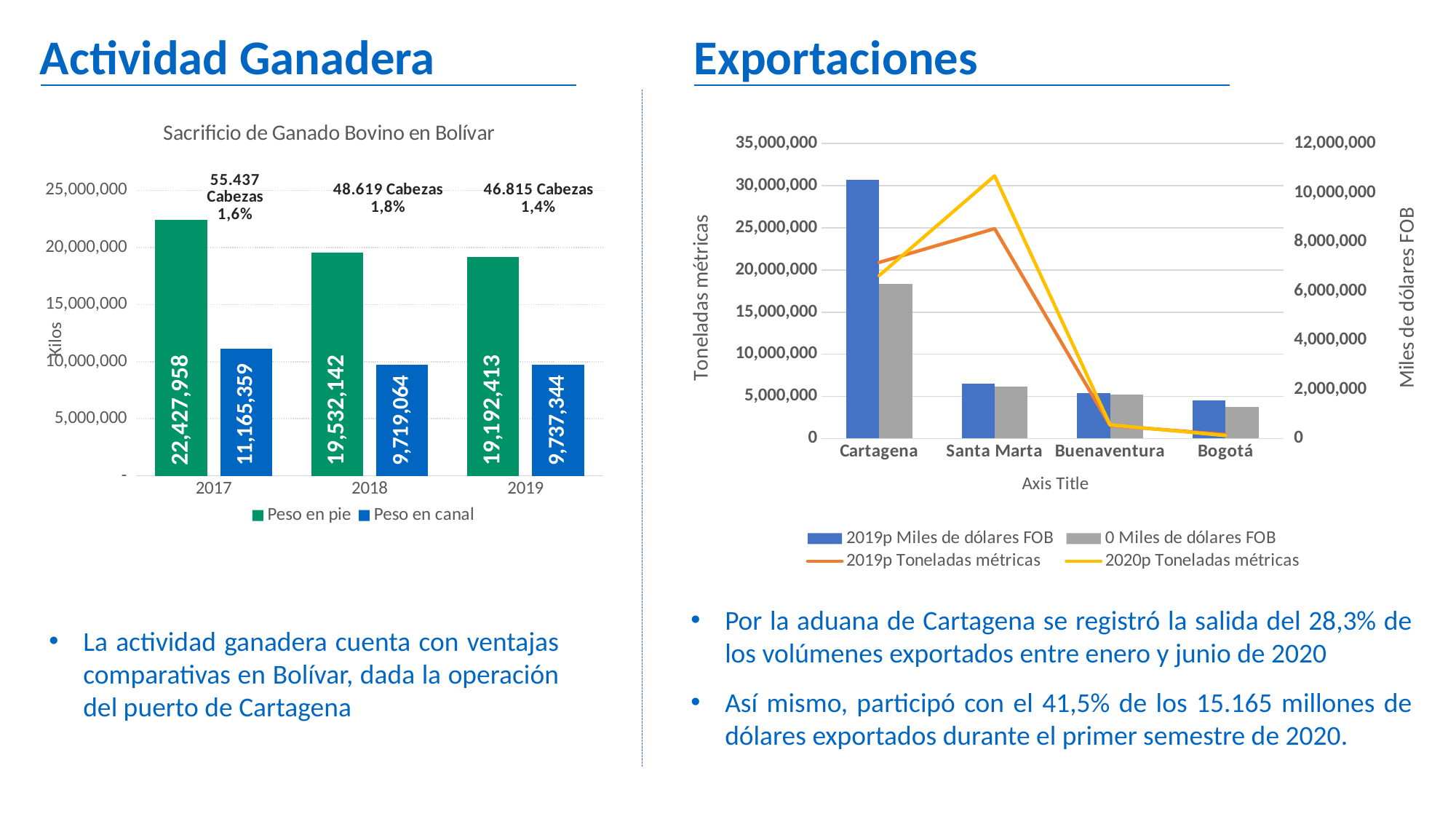
What kind of chart is the Exportaciones chart on the right? Combined bar and line chart In the 'Sacrificio de Ganado Bovino en Bolívar' chart, how many years are shown on the x axis? 3 How many series does the legend of the Exportaciones chart list? 4 In the 'Sacrificio de Ganado Bovino en Bolívar' chart, what is the value of Peso en canal for 2019? 9,737,344 In the 'Sacrificio de Ganado Bovino en Bolívar' chart, which year has the highest Peso en canal? 2017 In the Exportaciones chart, is the 2019p Miles de dólares FOB value for Cartagena greater or less than 30,000,000? less In the 'Sacrificio de Ganado Bovino en Bolívar' chart, what is the value of Peso en pie for 2017? 22,427,958 In the Exportaciones chart, which is larger for 2019p Miles de dólares FOB: Santa Marta or Bogotá? Santa Marta In the 'Sacrificio de Ganado Bovino en Bolívar' chart, what is the difference between Peso en pie and Peso en canal in 2017? 11,262,599 In the 'Sacrificio de Ganado Bovino en Bolívar' chart, what number of Cabezas is labelled for 2018? 48.619 Cabezas In the Exportaciones chart, which port has the highest 2019p Miles de dólares FOB bar? Cartagena In the 'Sacrificio de Ganado Bovino en Bolívar' chart, does Peso en pie rise or fall from 2017 to 2019? Fall